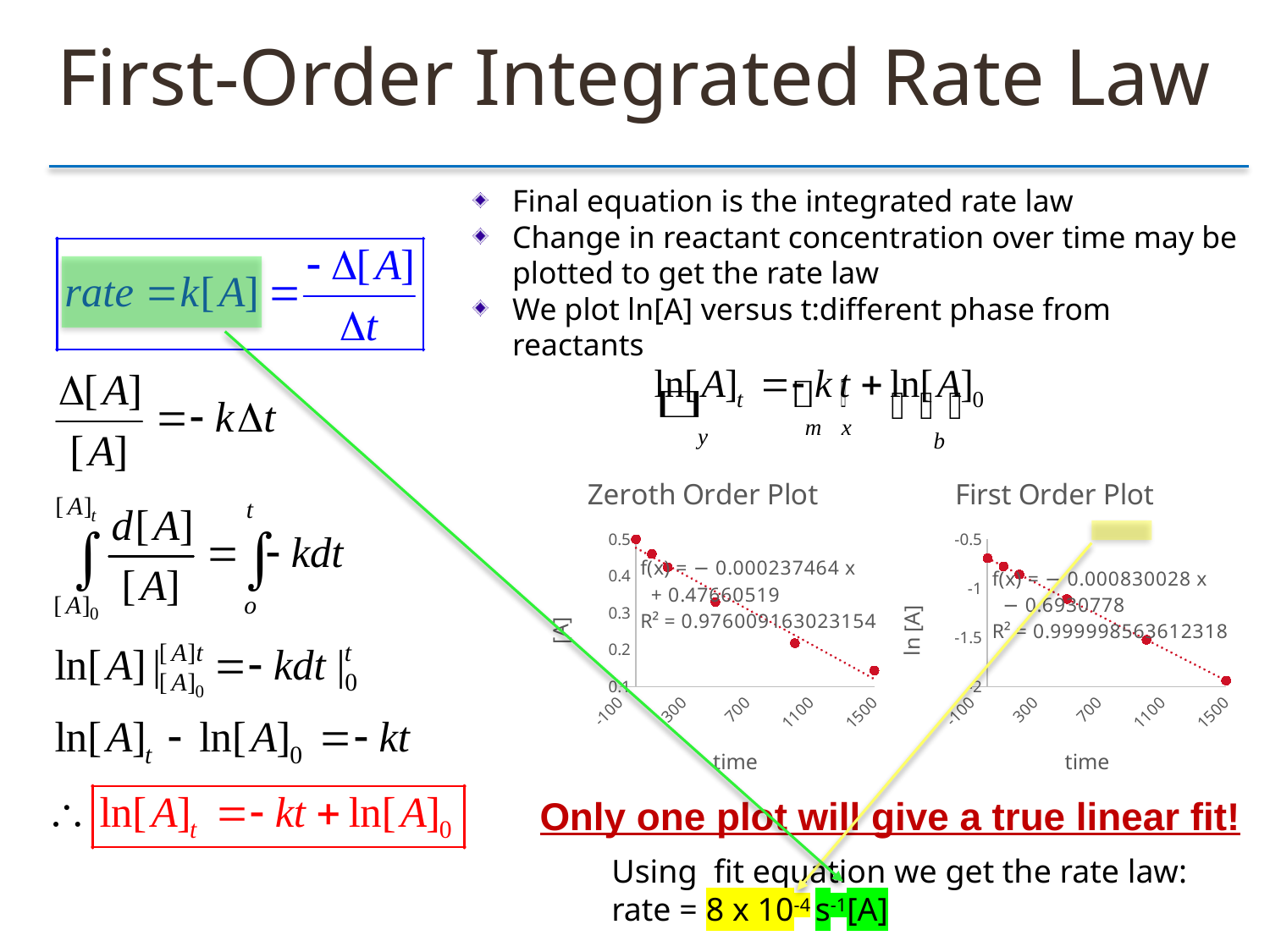
In the First Order Plot, do the values rise or fall as time increases? fall What is the label on the x axis of the First Order Plot? time Which plot has the higher R² value, the Zeroth Order Plot or the First Order Plot? First Order Plot In the Zeroth Order Plot, do the values rise or fall as time increases? fall What kind of chart is the First Order Plot? scatter plot In the Zeroth Order Plot, is the value at time 0 greater or less than 0.4? greater In the First Order Plot, is the value at time 1500 greater or less than -1.5? less What kind of chart is the Zeroth Order Plot? scatter plot In the First Order Plot, is the value at time 0 greater or less than -1? greater What is the R² value printed on the First Order Plot? 0.999998563612318